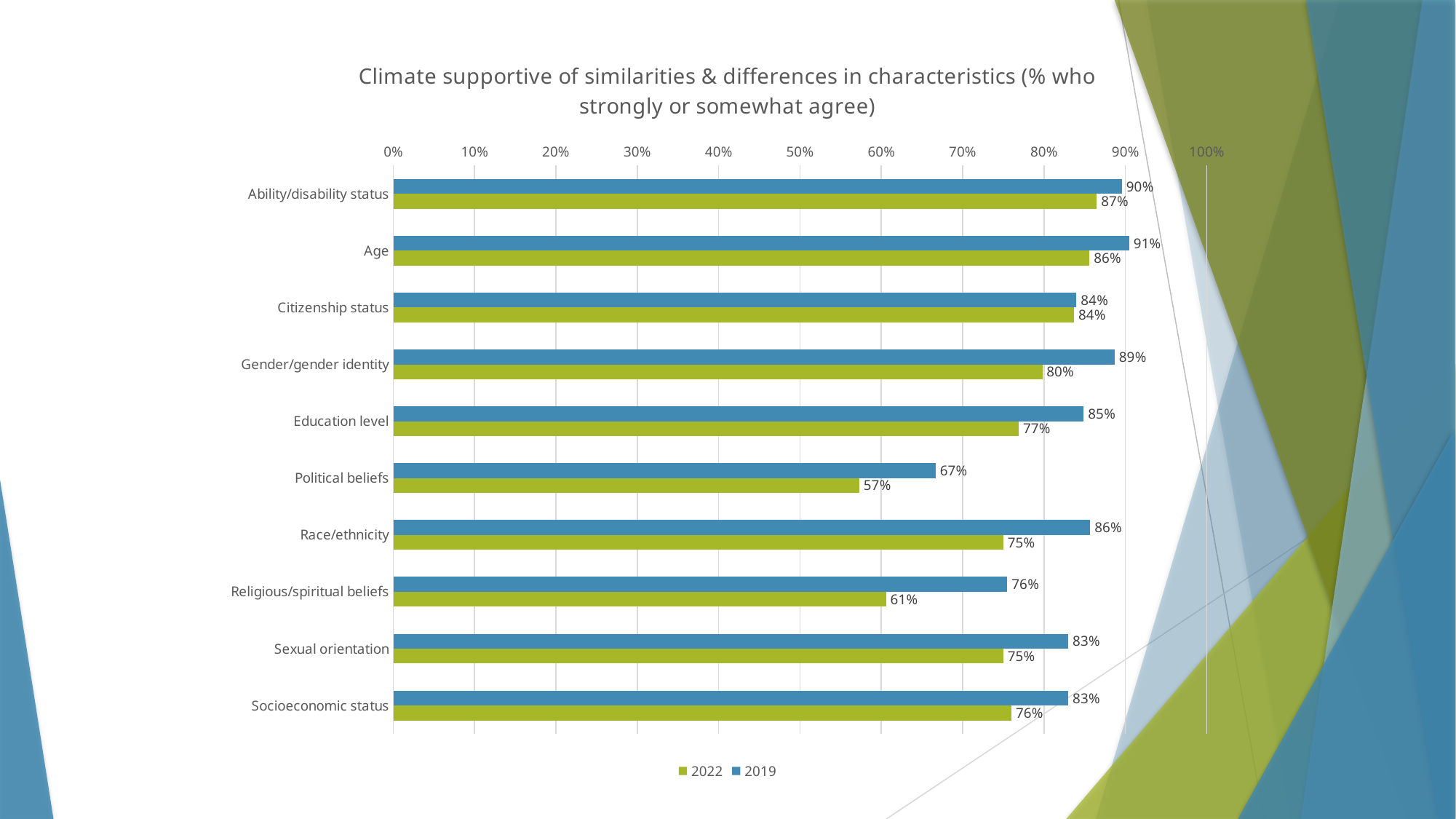
What is the 2019 value for Gender/gender identity? 89% Which category has the lowest 2022 value? Political beliefs What is the 2022 value for Political beliefs? 57% What is the 2022 value for Religious/spiritual beliefs? 61% Which is larger for Race/ethnicity, the 2019 value or the 2022 value? 2019 How many categories are shown on the chart? 10 Which category has the highest 2019 value? Age What kind of chart is shown on the slide? Bar chart What is the difference between the 2019 and 2022 values for Religious/spiritual beliefs? 15% What is the difference between the 2019 and 2022 values for Education level? 8% How many series does the legend list? 2 Which colour represents the 2022 series? Green